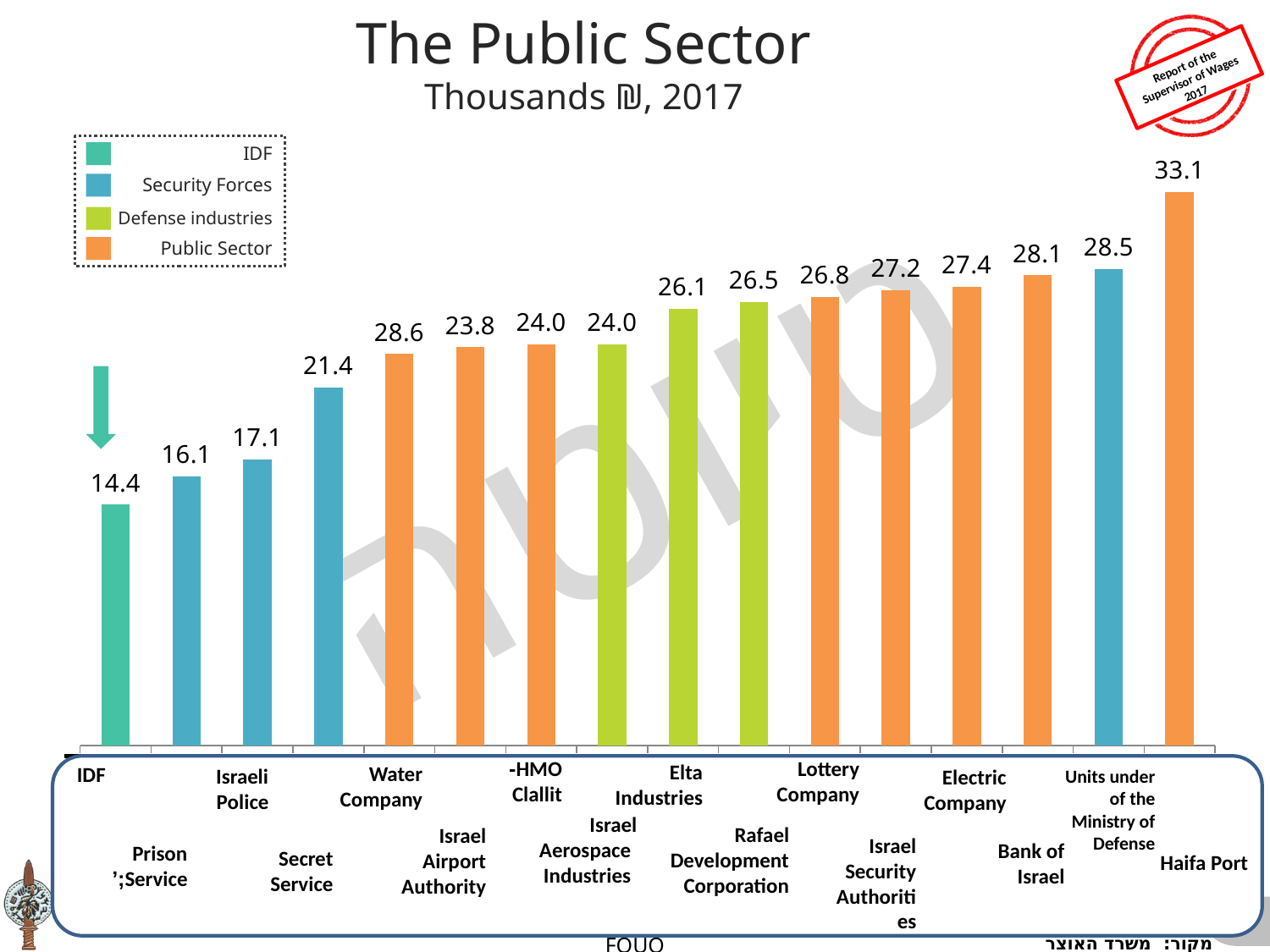
How many entries does the legend list? 4 Which category has the lowest value? IDF What kind of chart is shown on the slide? bar chart Which category has the highest value? Haifa Port What is the value for Bank of Israel? 28.1 What is the value for Haifa Port? 33.1 What is the value for Elta Industries? 26.1 What is the value for IDF? 14.4 What is the difference between the values for Haifa Port and IDF? 18.7 What is the value for Secret Service? 21.4 Which is larger, the value for Electric Company or the value for Lottery Company? Electric Company How many bars are plotted on the chart? 16